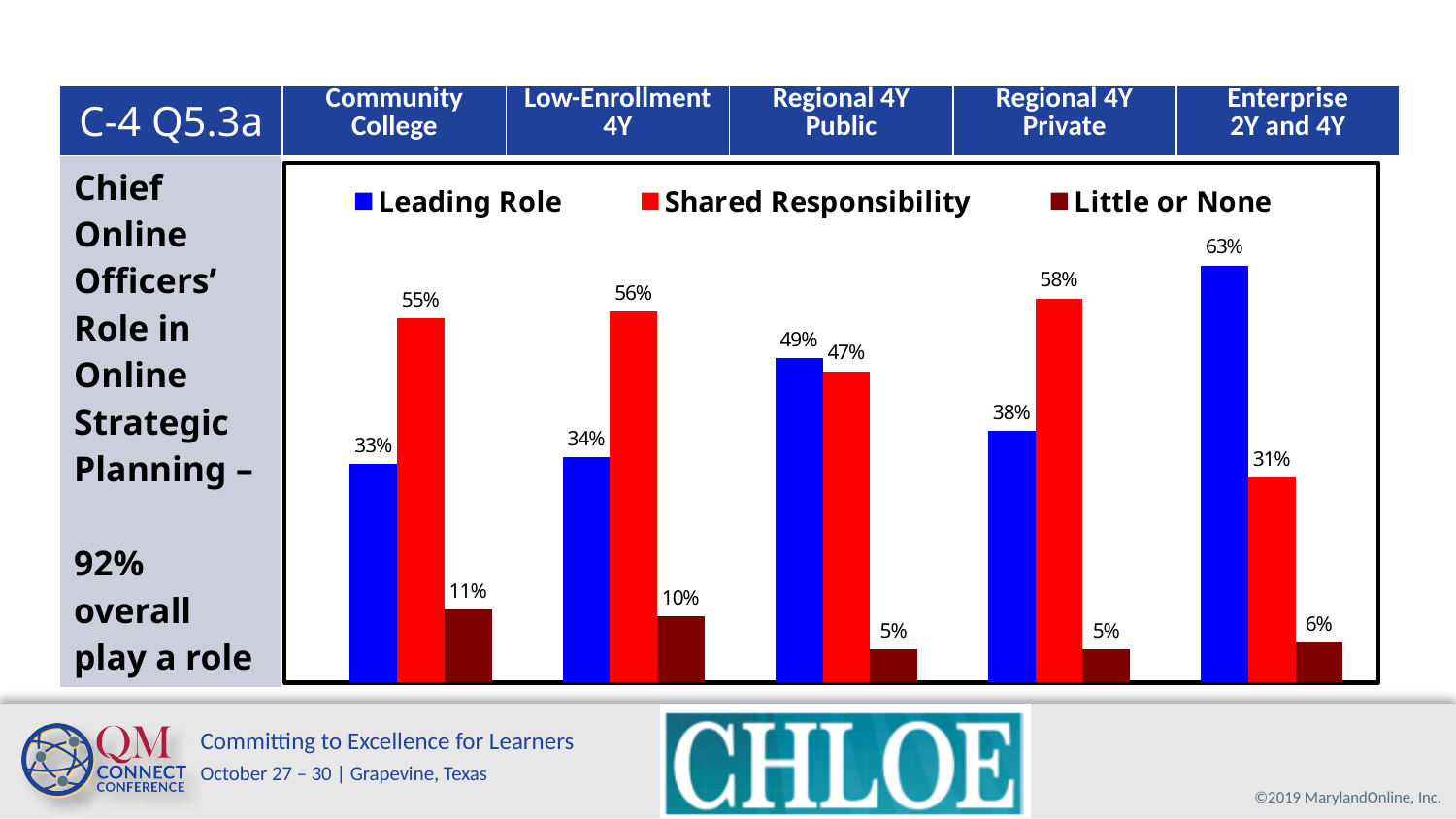
What is the Little or None value for Low-Enrollment 4Y? 10% Which category has the highest Leading Role value? Enterprise 2Y and 4Y How many categories are shown in the chart? 5 Which category has the lowest Shared Responsibility value? Enterprise 2Y and 4Y What is the difference between the Shared Responsibility and Leading Role values for Community College? 22% What is the Leading Role value for Community College? 33% How many series does the legend list? 3 What is the Shared Responsibility value for Regional 4Y Private? 58% What is the Leading Role value for Enterprise 2Y and 4Y? 63% What colour represents the Shared Responsibility series? Red For Regional 4Y Public, which is larger: Leading Role or Shared Responsibility? Leading Role What kind of chart is shown on the slide? Bar chart